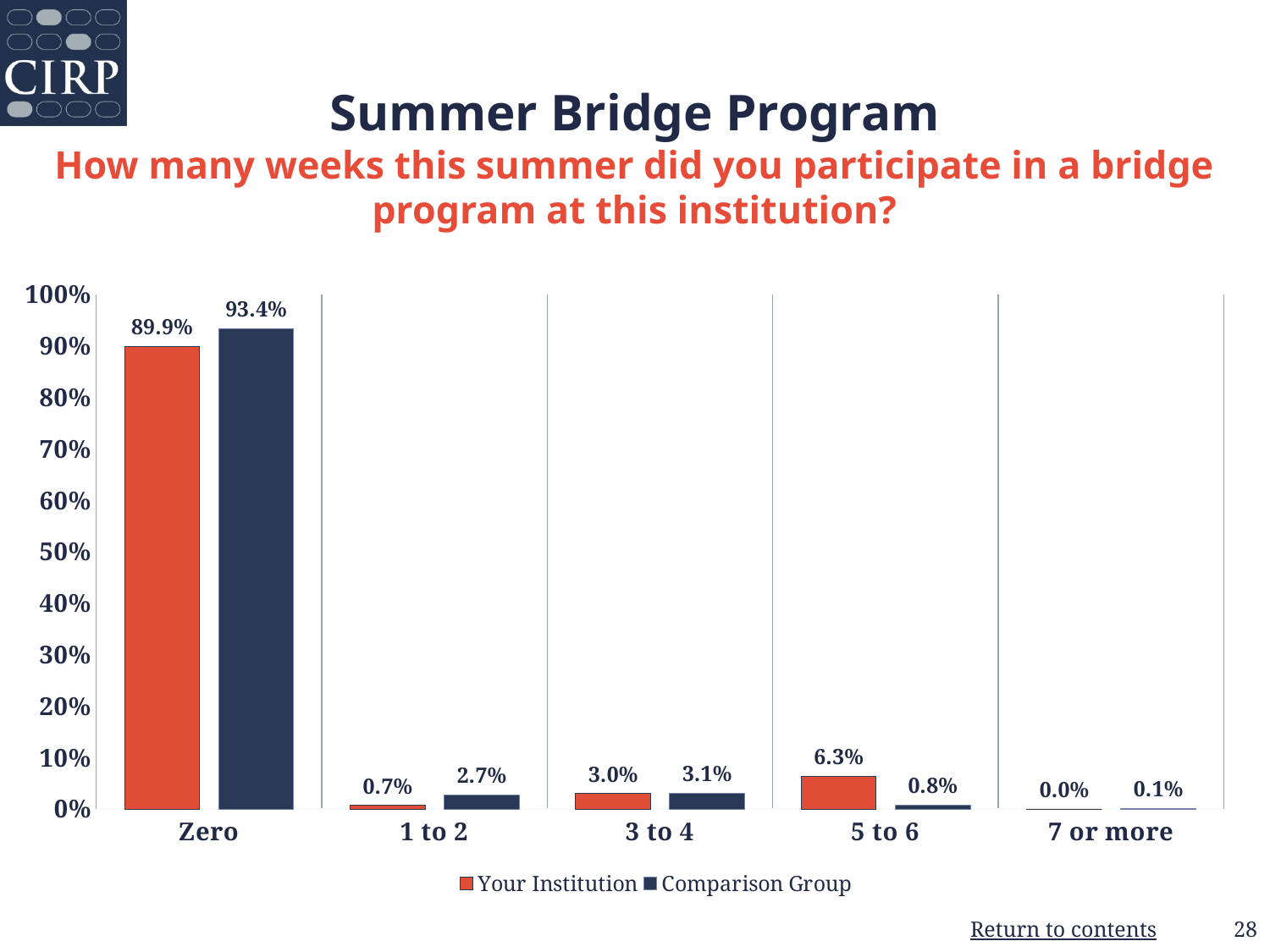
How many categories are shown on the x axis? 5 In the 5 to 6 category, which series has the larger value, Your Institution or Comparison Group? Your Institution What is the value for Your Institution in the Zero category? 89.9% Which colour represents Comparison Group in the legend? dark navy blue Which category has the highest value for Comparison Group? Zero What is the difference between Comparison Group and Your Institution in the Zero category? 3.5% Is the value for Your Institution in the Zero category greater or less than 80%? greater Which category has the lowest value for Your Institution? 7 or more What is the value for Your Institution in the 1 to 2 category? 0.7% What kind of chart is shown on the slide? bar chart How many series does the legend list? 2 What is the value for Comparison Group in the 5 to 6 category? 0.8%